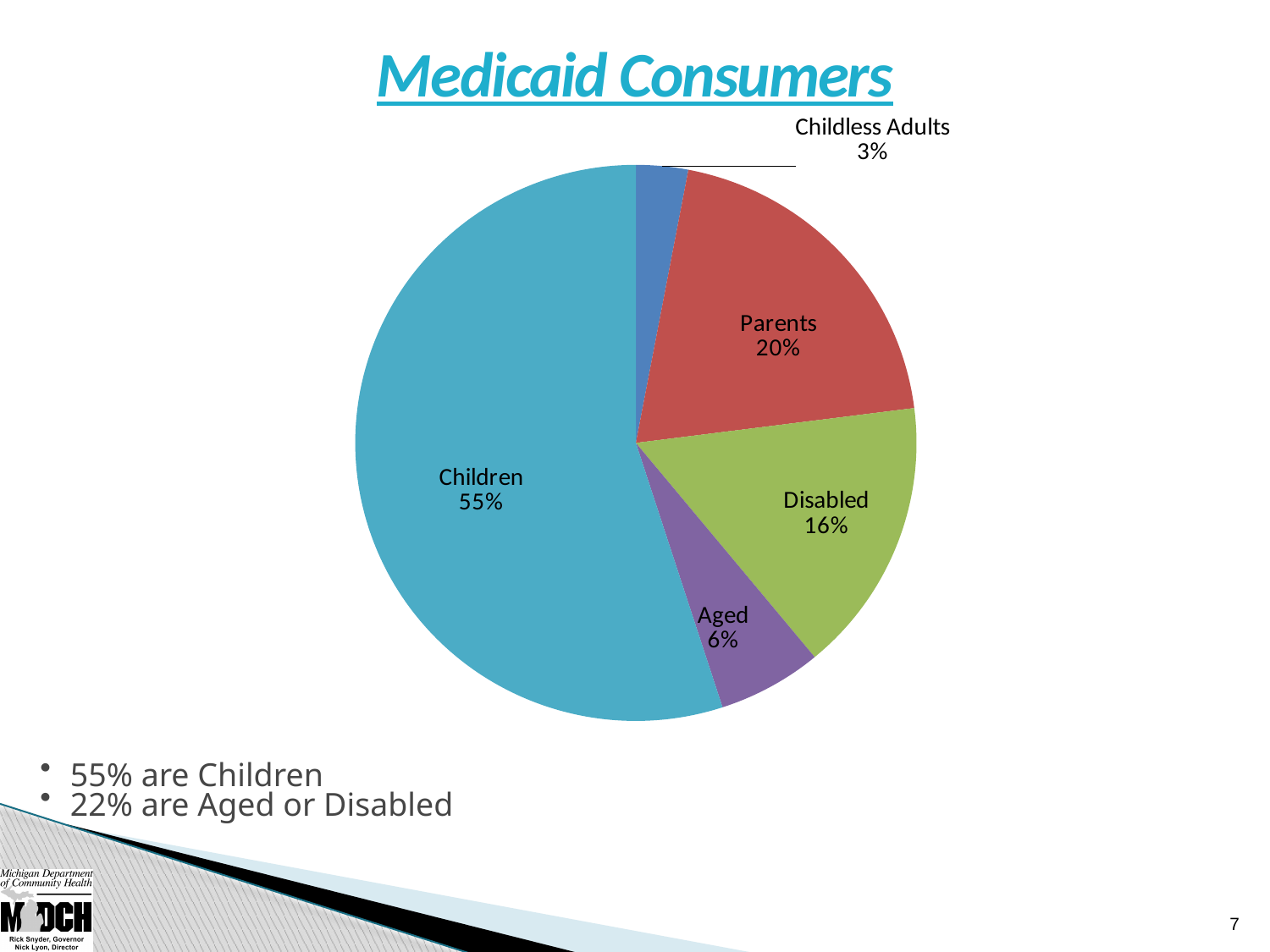
What percentage of the pie is labelled Parents? 20% What share of Medicaid consumers are Disabled? 16% What is the title of the chart? Medicaid Consumers What is the difference in percentage points between the Parents and Disabled slices? 4 How many categories are shown in the pie chart? 5 Which category has the largest slice of the pie? Children What share of Medicaid consumers are Childless Adults? 3% Which slice is larger, Aged or Childless Adults? Aged What share of Medicaid consumers are Children? 55% Which category has the smallest slice of the pie? Childless Adults What percentage of the pie is labelled Aged? 6% What kind of chart is shown on the slide? Pie chart